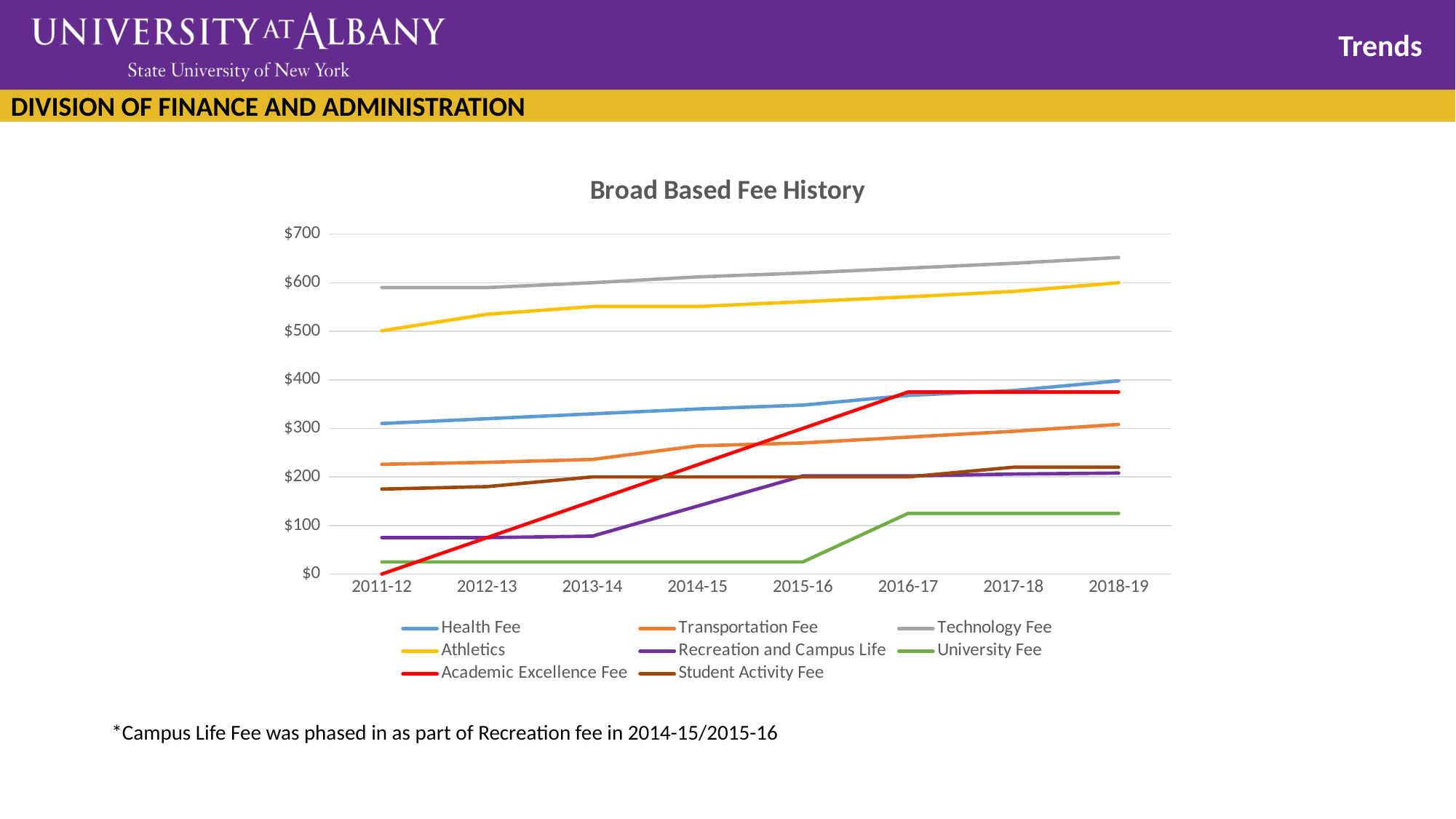
Does the Technology Fee rise or fall from 2011-12 to 2018-19? rise How many series does the legend list? 8 How many academic years are shown on the x axis? 8 What is the title of the chart? Broad Based Fee History In 2014-15, which is larger: Athletics or the Health Fee? Athletics Is the value for the University Fee in 2016-17 greater or less than $100? greater Which fee is the highest in 2018-19? Technology Fee Which fee is the lowest in 2018-19? University Fee What is the value of the Academic Excellence Fee in 2011-12? $0 Is the value for the Technology Fee in 2011-12 greater or less than $500? greater What kind of chart is shown on the slide? line chart